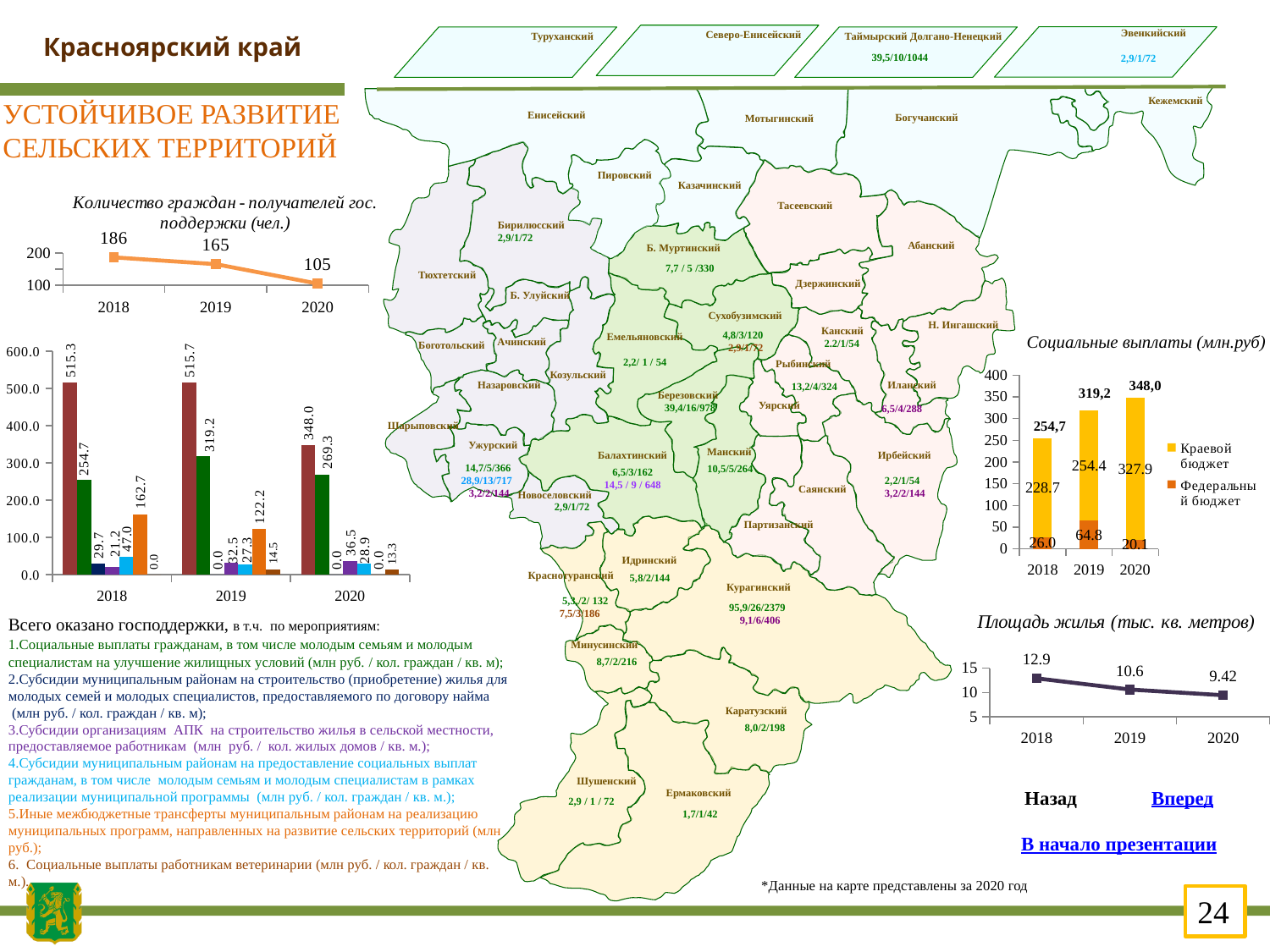
What kind of chart is 'Площадь жилья (тыс. кв. метров)'? line chart In the chart 'Социальные выплаты (млн.руб)', how many series does the legend list? 2 In the chart 'Количество граждан - получателей гос. поддержки (чел.)', what is the difference between the 2018 and 2020 values? 81 In the chart 'Площадь жилья (тыс. кв. метров)', what is the value for 2020? 9.42 In the bar chart on the left of the slide, what is the value of the tallest bar in the 2020 group? 348.0 In the chart 'Количество граждан - получателей гос. поддержки (чел.)', do the values rise or fall from 2018 to 2020? fall In the chart 'Социальные выплаты (млн.руб)', what is the total of the stacked bar for 2020? 348,0 In the chart 'Социальные выплаты (млн.руб)', which year has the highest 'Федеральный бюджет' value? 2019 In the chart 'Социальные выплаты (млн.руб)', what is the value of 'Федеральный бюджет' for 2018? 26.0 In the chart 'Количество граждан - получателей гос. поддержки (чел.)', which year has the lowest value? 2020 In the chart 'Количество граждан - получателей гос. поддержки (чел.)', what is the value for 2018? 186 In the chart 'Социальные выплаты (млн.руб)', what is the value of 'Краевой бюджет' for 2019? 254.4